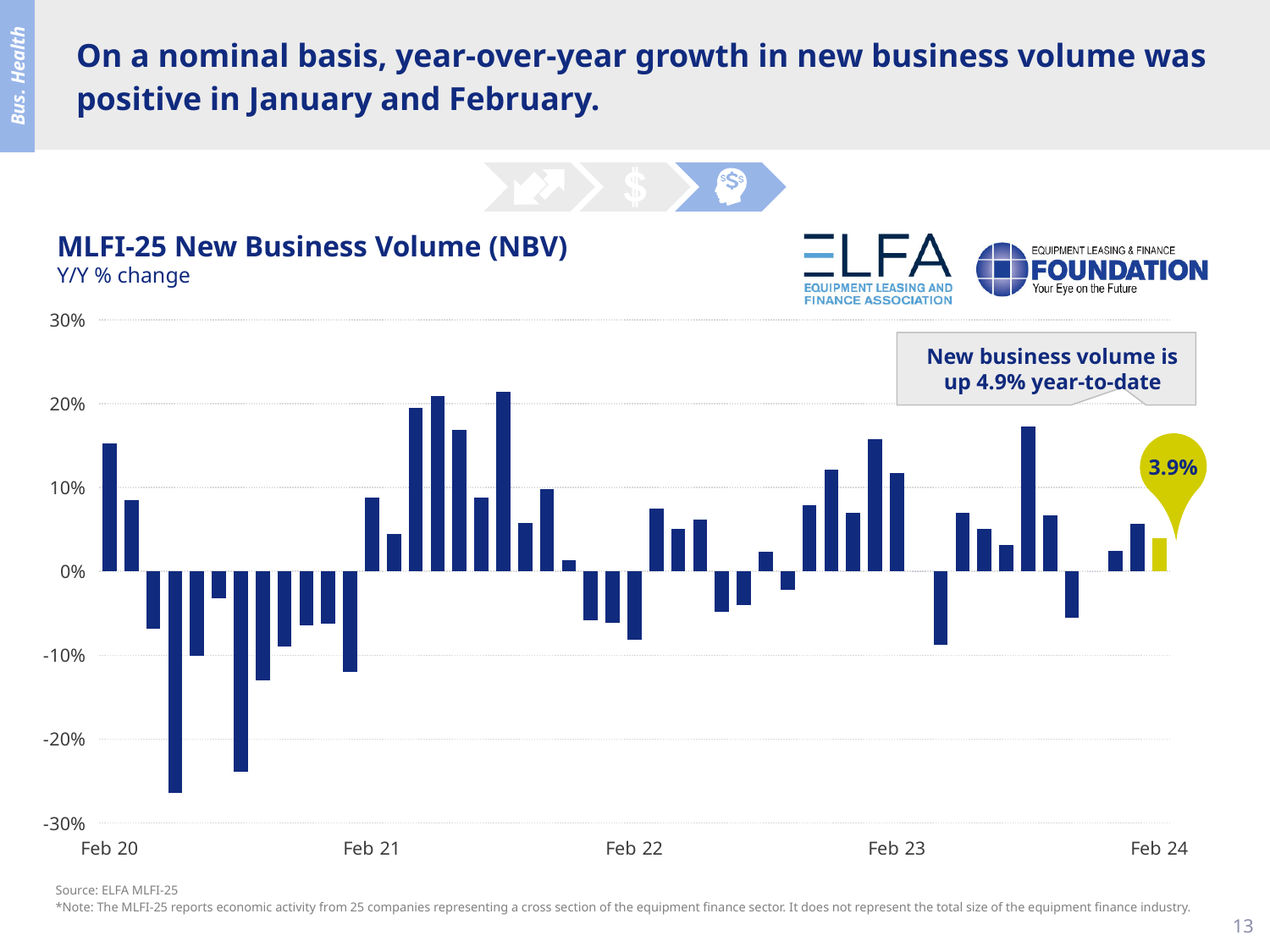
Is the value for Feb 23 greater or less than 0%? greater Is the lowest value on the chart greater or less than -20%? less What kind of chart is used to show MLFI-25 New Business Volume? Bar chart Which is larger, the value for Feb 20 or the value for Feb 24? Feb 20 Is the value for Feb 24 greater or less than 10%? less What is the title of the chart? MLFI-25 New Business Volume (NBV) How many year labels are shown on the x axis? 5 What is the Y/Y % change in new business volume shown for Feb 24? 3.9% According to the callout box on the chart, by how much is new business volume up year-to-date? 4.9%